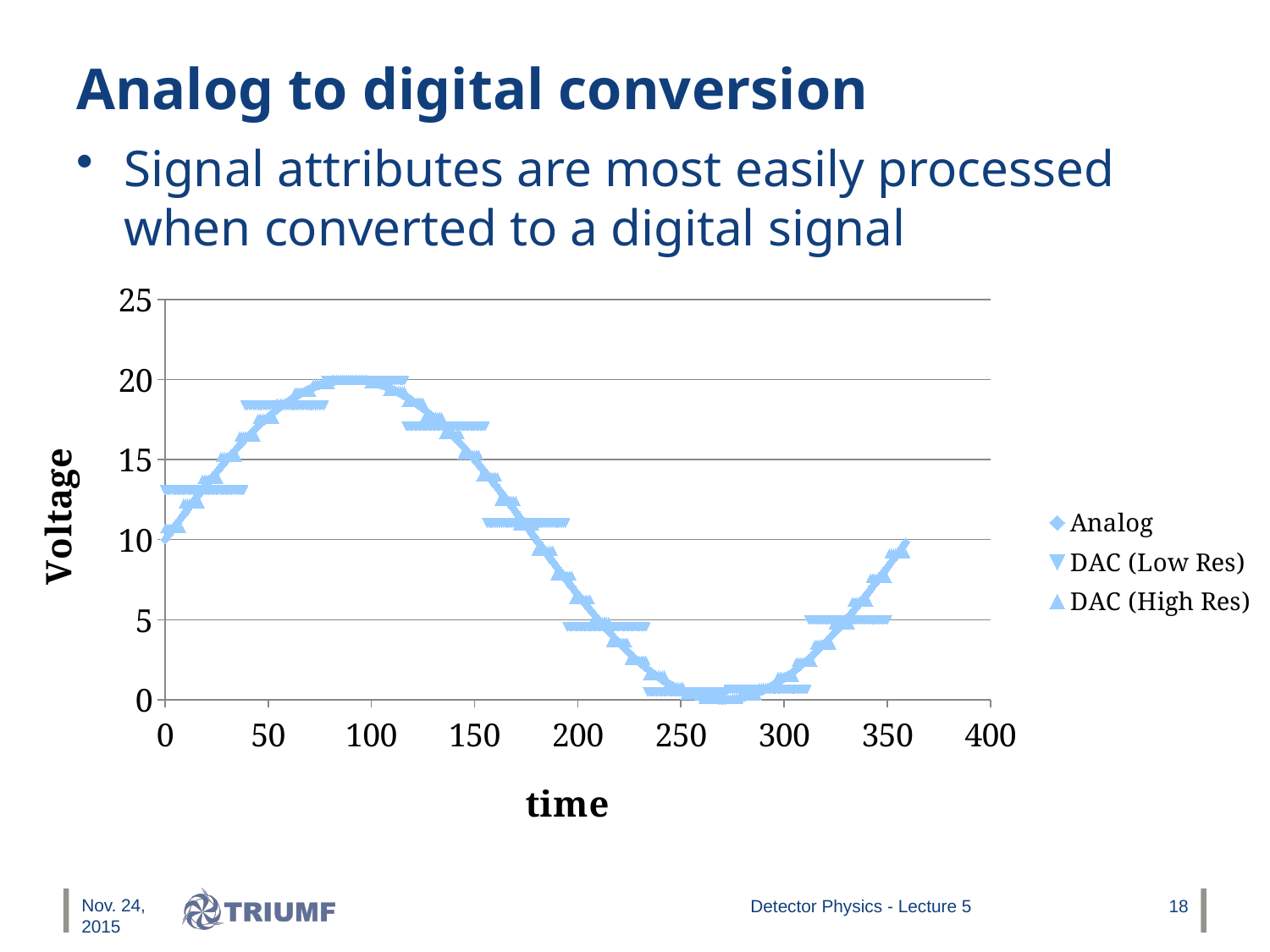
How many series does the legend list? 3 What are the names of the series listed in the legend? Analog, DAC (Low Res), DAC (High Res) Is the Analog value at time 50 greater or less than 15? greater What kind of chart is shown on the slide? scatter chart Does the Analog signal rise or fall between time 100 and time 270? fall Is the Analog value larger at time 100 or at time 270? time 100 Is the Analog value at time 100 greater or less than 15? greater Is the Analog value larger at time 200 or at time 50? time 50 Is the Analog value at time 0 greater or less than 5? greater What is the title of the vertical axis? Voltage Does the Analog signal rise or fall between time 0 and time 90? rise